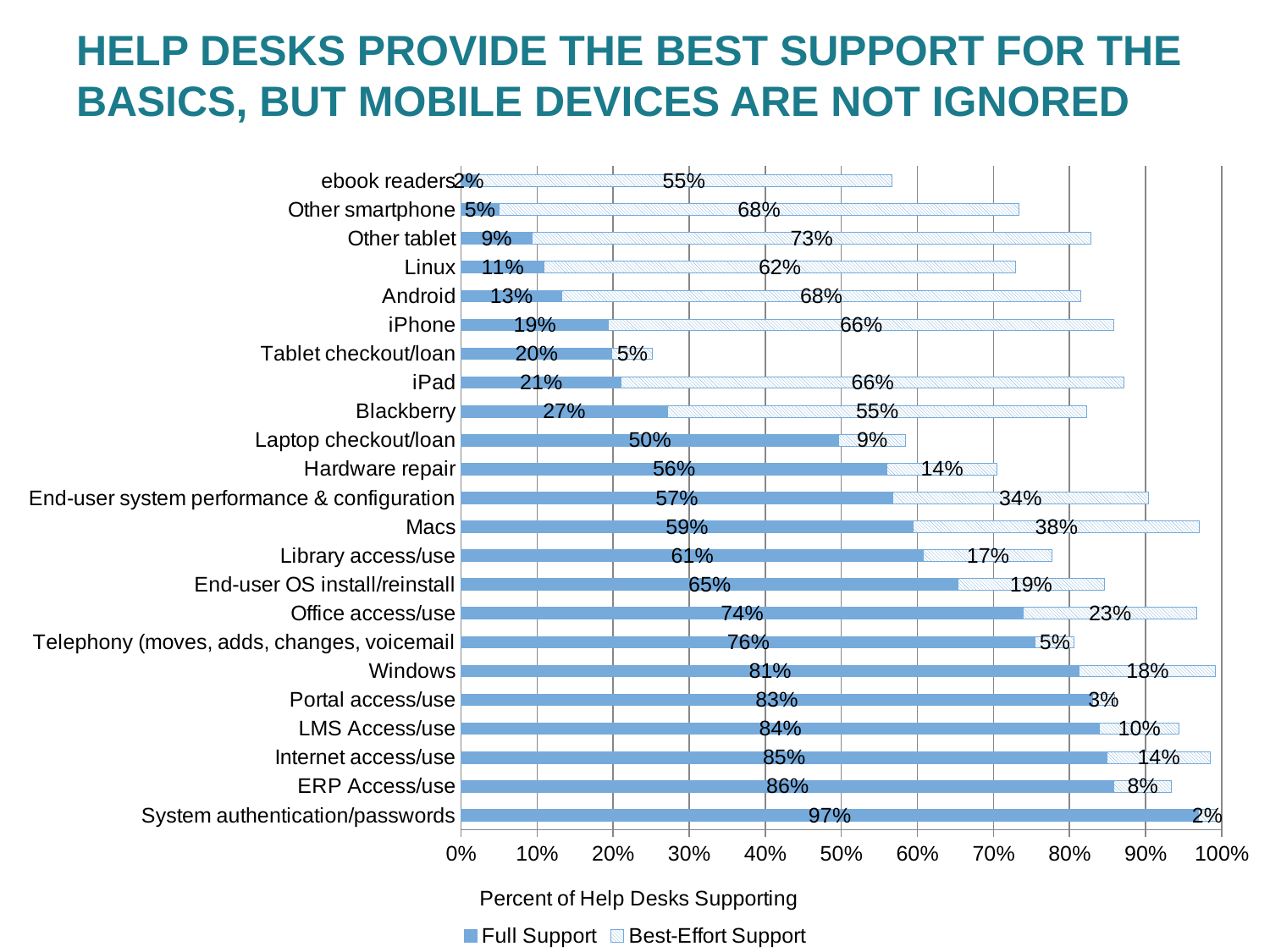
How many categories are shown on the chart? 23 What kind of chart is shown on the slide? Stacked bar chart What is the Full Support value for Blackberry? 27% Which category has the highest Full Support value? System authentication/passwords What is the difference between the Full Support values for Internet access/use and Hardware repair? 29% What is the total of the stacked bar for Windows (Full Support plus Best-Effort Support)? 99% How many series does the legend list? 2 Which category has the lowest Full Support value? ebook readers Which has a larger Best-Effort Support value, Macs or Office access/use? Macs What is the Best-Effort Support value for Other tablet? 73% What is the Full Support value for Windows? 81% What is the title of the horizontal axis? Percent of Help Desks Supporting